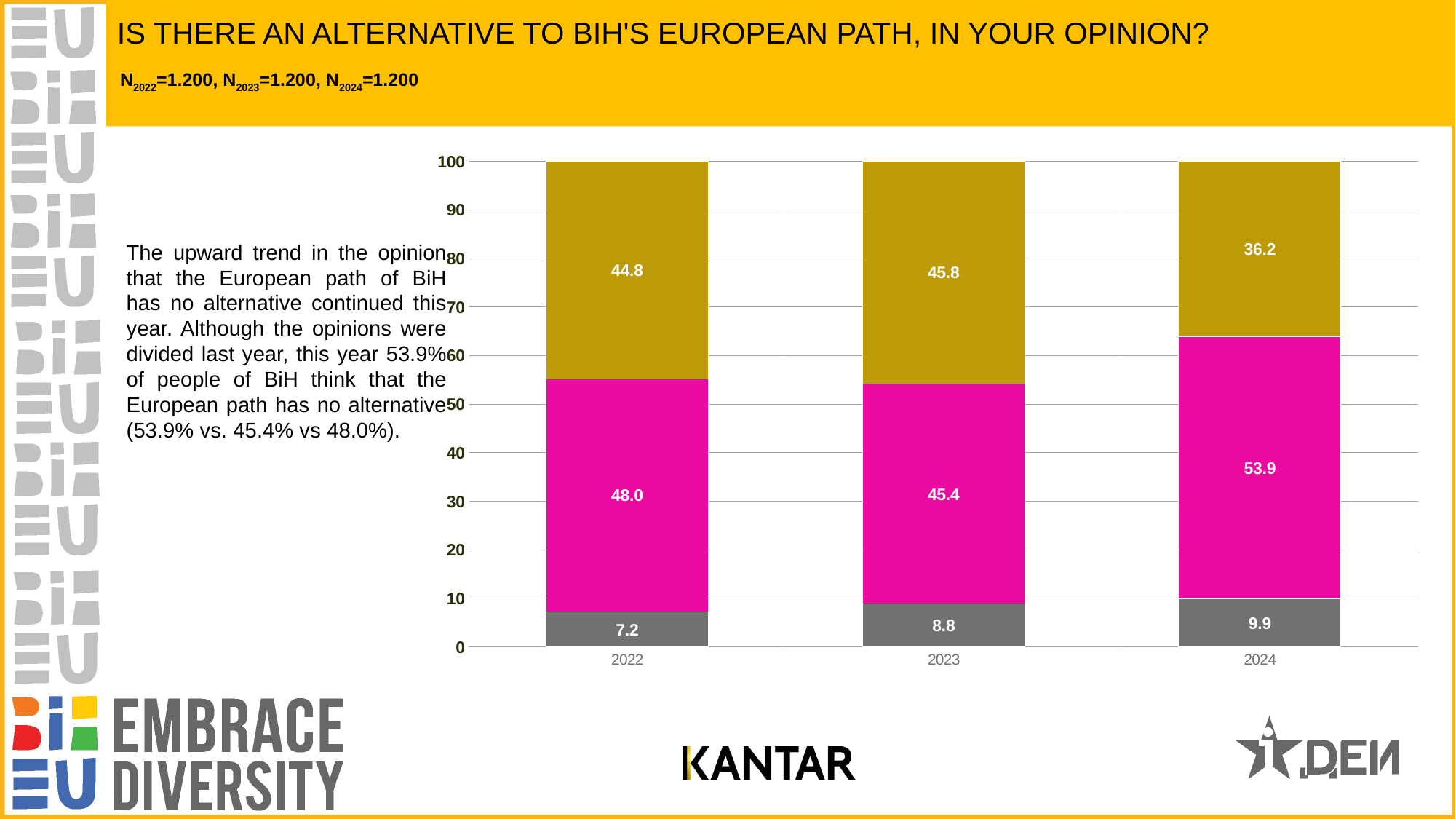
What is the value of the pink segment for 2024? 53.9 How many years are shown on the x axis? 3 What is the value of the gold segment for 2023? 45.8 What is the value of the grey segment for 2022? 7.2 Does the grey segment rise or fall from 2022 to 2024? Rises What is the total of the three segments in the 2022 bar? 100.0 What kind of chart is shown on the slide? Stacked bar chart In which year is the grey segment the smallest? 2022 In which year is the pink segment the largest? 2024 What is the difference between the gold segment in 2022 and in 2024? 8.6 Which year has the larger gold segment, 2022 or 2024? 2022 By how much did the pink segment increase from 2023 to 2024? 8.5